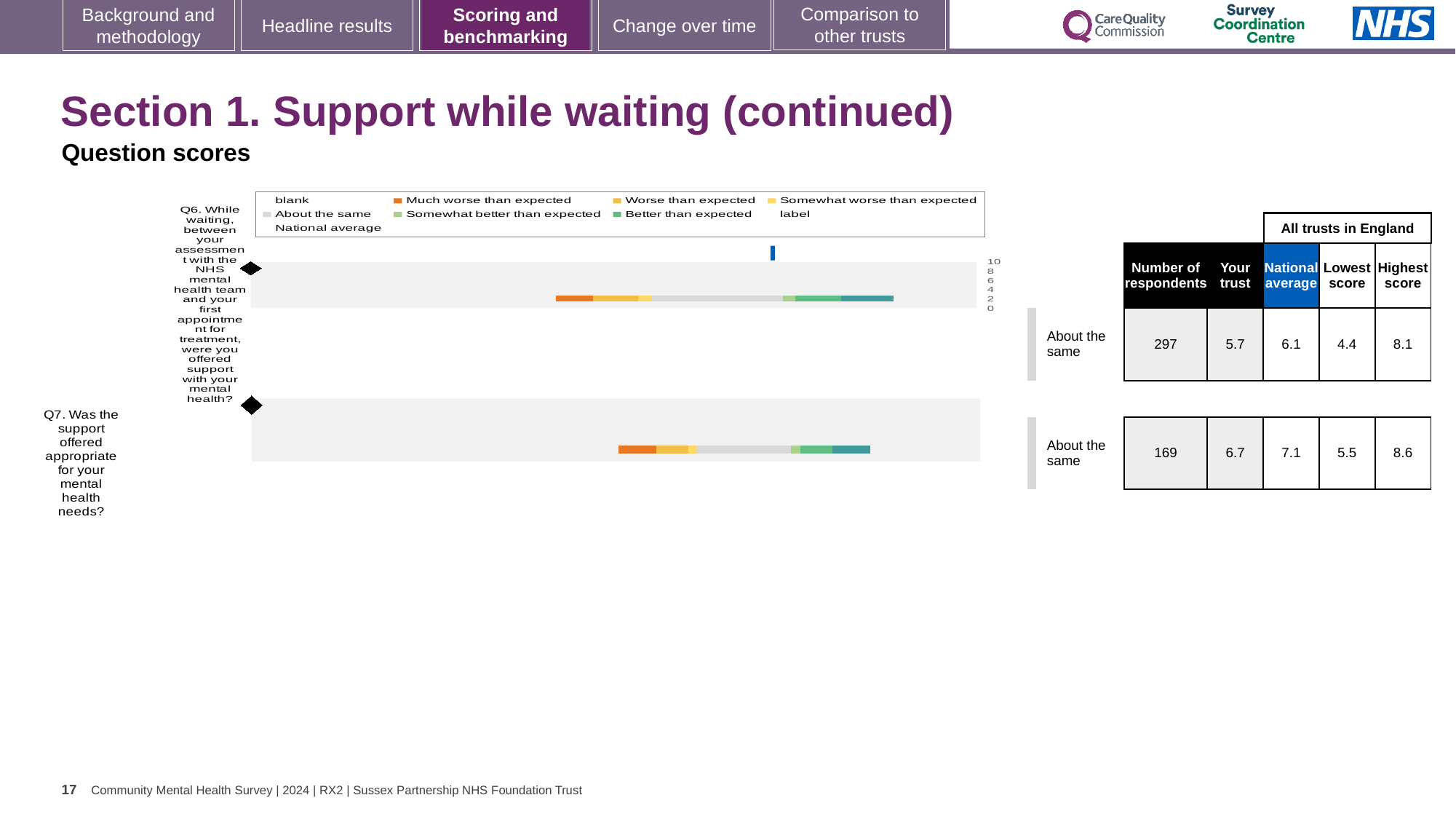
What kind of chart is shown on the slide? bar chart Which question has more respondents, Q6 or Q7? Q6 How many questions (bars) are plotted in the chart? 2 What is the 'Your trust' score for Q6? 5.7 What is the difference between the highest score and the lowest score for Q7? 3.1 What colour represents 'Much worse than expected' in the chart legend? orange What benchmark category is Q7 placed in? About the same What is the national average score for Q7? 7.1 How many respondents answered Q6? 297 How many entries does the chart legend list? 9 Which legend entry is shown in light grey? About the same For Q6, which is larger: the 'Your trust' score or the national average? National average